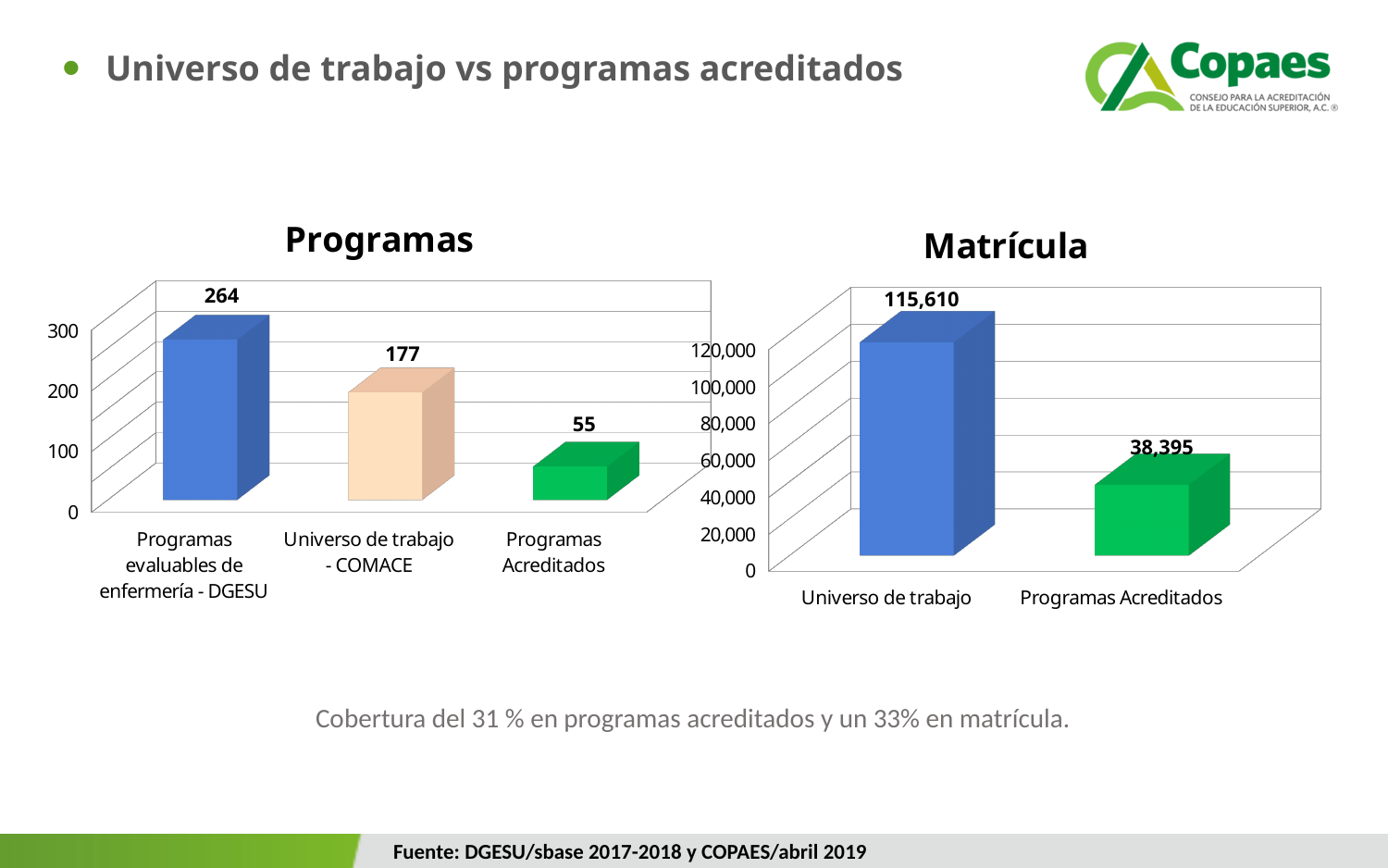
In the 'Programas' chart, what is the value for 'Programas Acreditados'? 55 In the 'Programas' chart, what is the difference between 'Programas evaluables de enfermería - DGESU' and 'Universo de trabajo - COMACE'? 87 In the 'Matrícula' chart, which category has the highest value? Universo de trabajo In the 'Matrícula' chart, what is the value for 'Programas Acreditados'? 38,395 In the 'Programas' chart, which category has the lowest value? Programas Acreditados In the 'Programas' chart, what is the value for 'Programas evaluables de enfermería - DGESU'? 264 In the 'Matrícula' chart, what is the value for 'Universo de trabajo'? 115,610 In the 'Programas' chart, what colour is the bar for 'Universo de trabajo - COMACE'? Peach (light orange) In the 'Matrícula' chart, what is the difference between 'Universo de trabajo' and 'Programas Acreditados'? 77,215 What kind of chart is the 'Matrícula' chart? Bar chart In the 'Programas' chart, how many categories are shown? 3 In the 'Programas' chart, what is the value for 'Universo de trabajo - COMACE'? 177